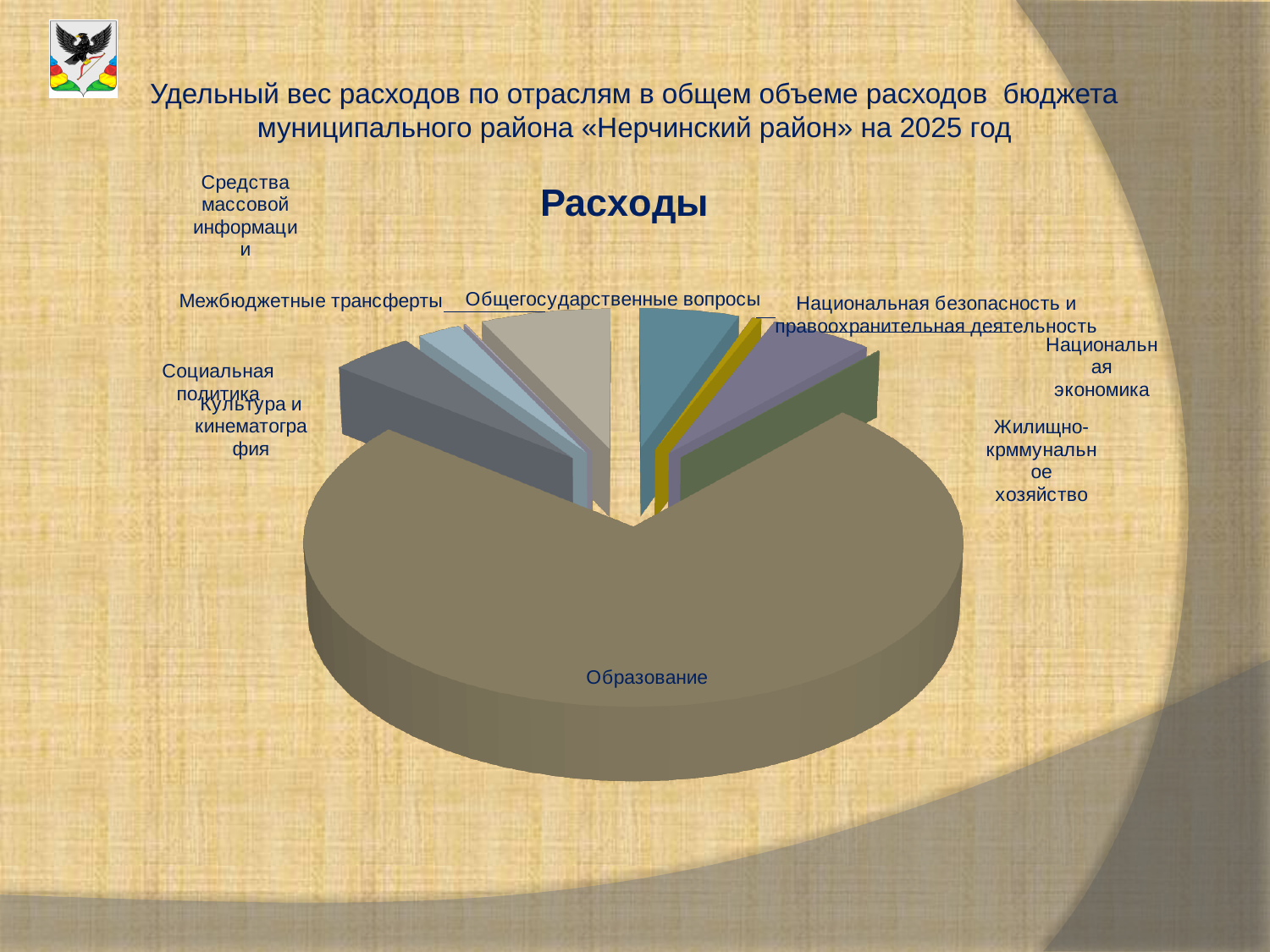
Which category has the largest slice in the pie chart? Образование Which is larger in the pie chart: Образование or Национальная экономика? Образование Is the pie chart drawn in 3D or flat 2D? 3D How many categories (slices) are labelled in the pie chart? 9 Which is larger in the pie chart: Образование or Общегосударственные вопросы? Образование What kind of chart is shown on the slide? Pie chart Which is larger in the pie chart: Образование or Социальная политика? Образование What is the title of the pie chart? Расходы